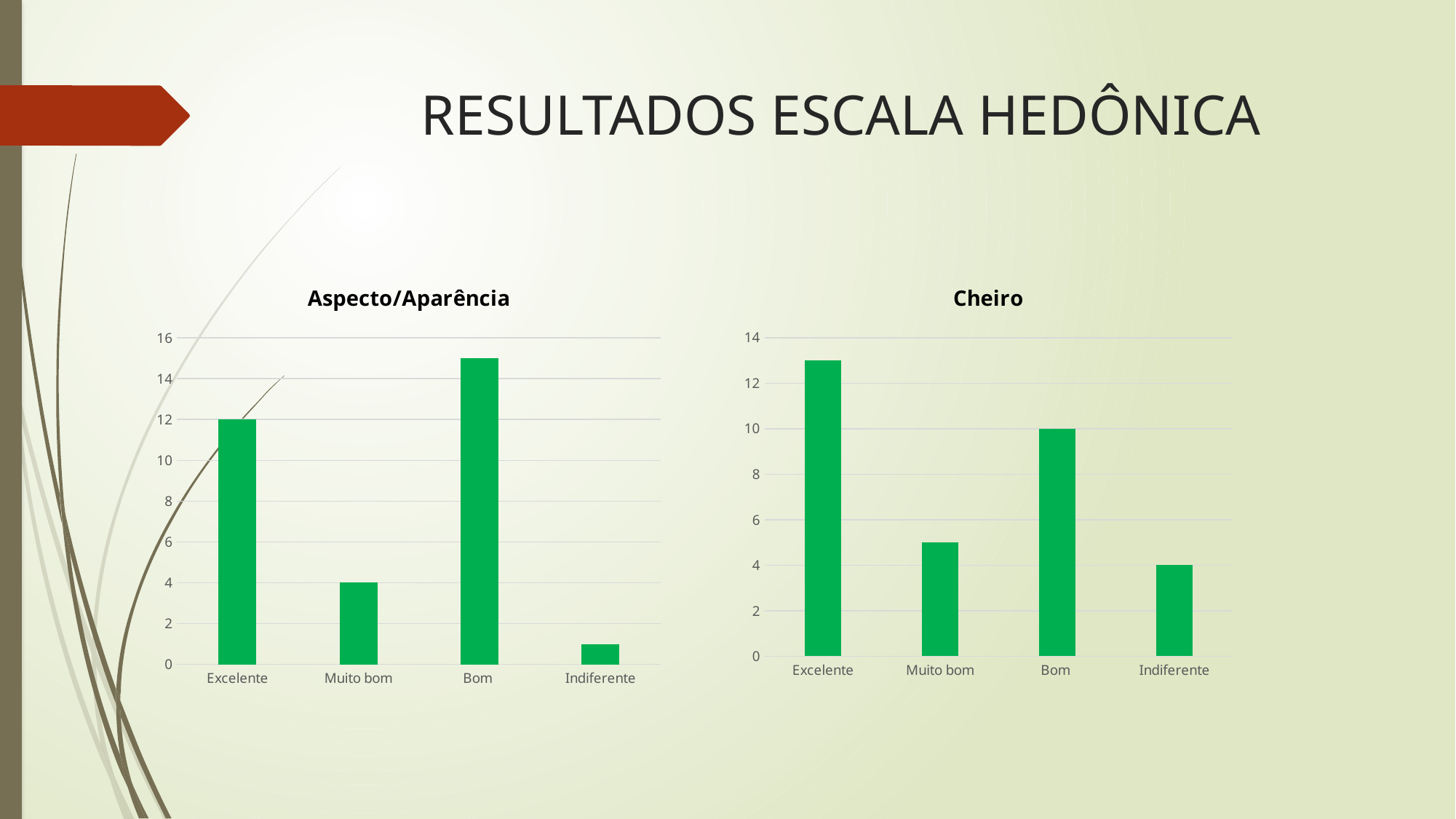
How many categories does the Cheiro chart show? 4 In the Cheiro chart, which category has the highest value? Excelente In the Cheiro chart, what is the value for Bom? 10 In the Cheiro chart, is the value for Excelente greater or less than 12? greater In the Cheiro chart, what is the value for Indiferente? 4 In the Aspecto/Aparência chart, which category has the highest value? Bom In the Aspecto/Aparência chart, what is the value for Muito bom? 4 In the Cheiro chart, which is larger, the value for Muito bom or the value for Bom? Bom In the Aspecto/Aparência chart, is the value for Bom greater or less than 14? greater In the Aspecto/Aparência chart, what is the value for Excelente? 12 In the Aspecto/Aparência chart, what is the difference between the values for Excelente and Muito bom? 8 In the Aspecto/Aparência chart, which category has the lowest value? Indiferente